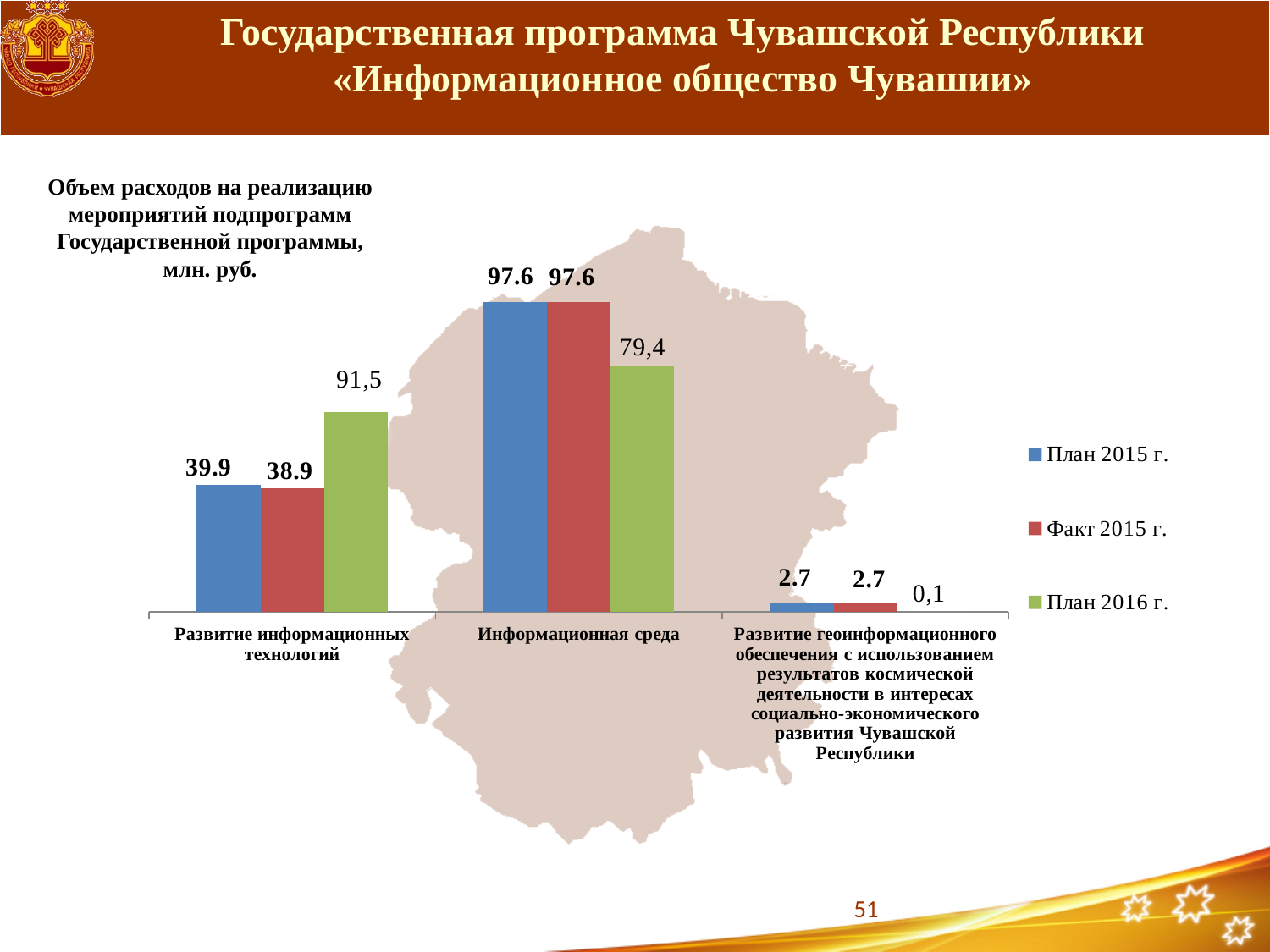
How many categories are shown on the x axis of the chart? 3 What is the value of План 2015 г. for Развитие информационных технологий? 39.9 What unit is given in the chart title for the expenditure values? млн. руб. What is the value of План 2016 г. for Развитие геоинформационного обеспечения с использованием результатов космической деятельности в интересах социально-экономического развития Чувашской Республики? 0,1 Which category has the lowest value for План 2016 г.? Развитие геоинформационного обеспечения с использованием результатов космической деятельности в интересах социально-экономического развития Чувашской Республики How many series does the legend list? 3 What is the value of Факт 2015 г. for Развитие информационных технологий? 38.9 What is the difference between План 2016 г. and План 2015 г. for Развитие информационных технологий? 51.6 For Информационная среда, which is larger: Факт 2015 г. or План 2016 г.? Факт 2015 г. Which category has the highest value for План 2015 г.? Информационная среда What kind of chart is shown on the slide? Bar chart What is the value of План 2016 г. for Информационная среда? 79,4